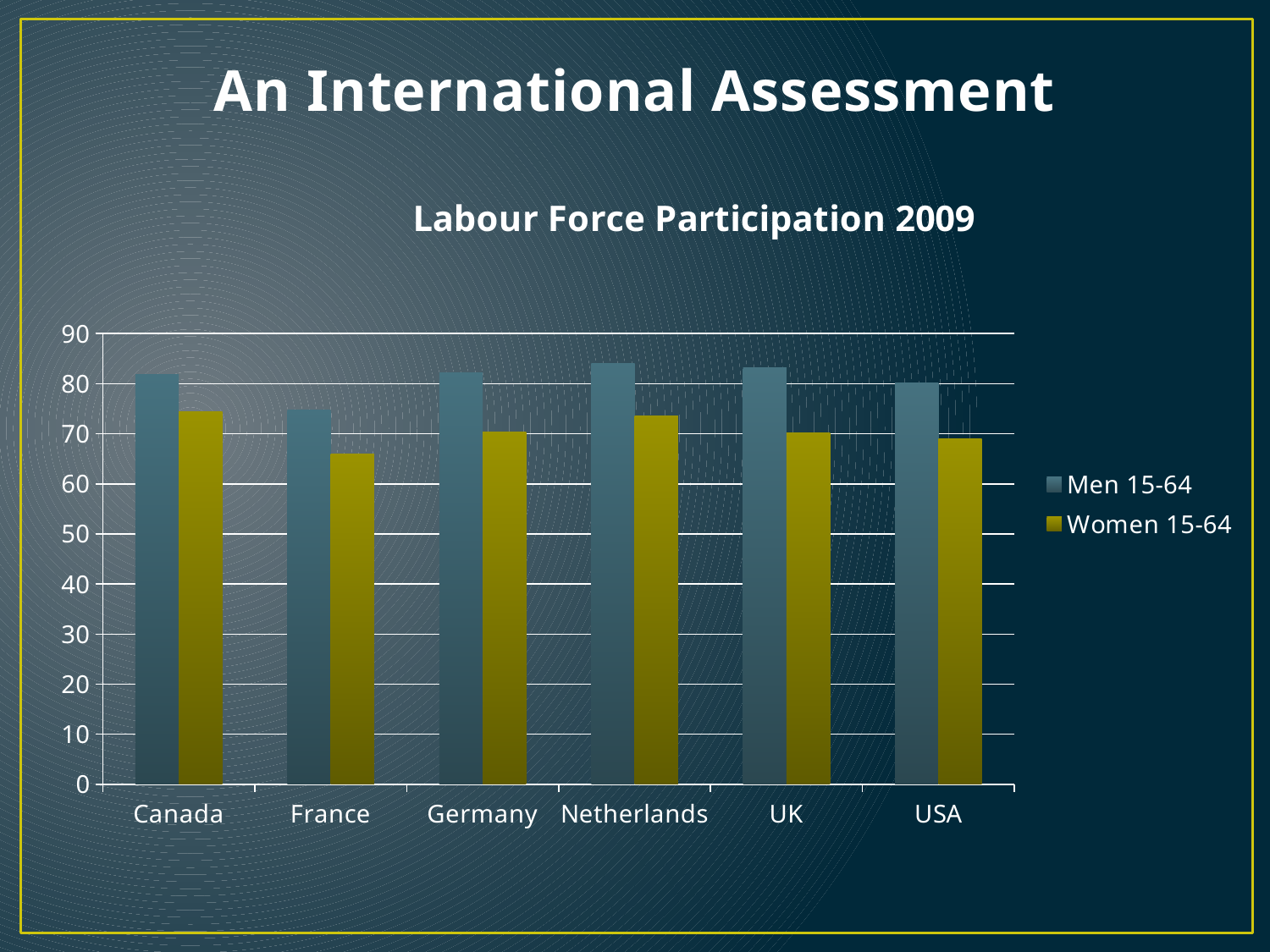
Is the value for Women 15-64 in France greater or less than 70? less Is the value for Men 15-64 in France greater or less than 80? less What is the title of the chart? Labour Force Participation 2009 Which two series are listed in the legend? Men 15-64 and Women 15-64 What kind of chart is shown on the slide? bar chart Which country has the lowest value for Women 15-64? France For Women 15-64, which is larger: the value for France or Germany? Germany Is the value for Men 15-64 in Canada greater or less than 80? greater How many countries are shown on the x axis of the chart? 6 Which country has the lowest value for Men 15-64? France In Canada, which is larger: the value for Men 15-64 or Women 15-64? Men 15-64 How many series does the legend list? 2